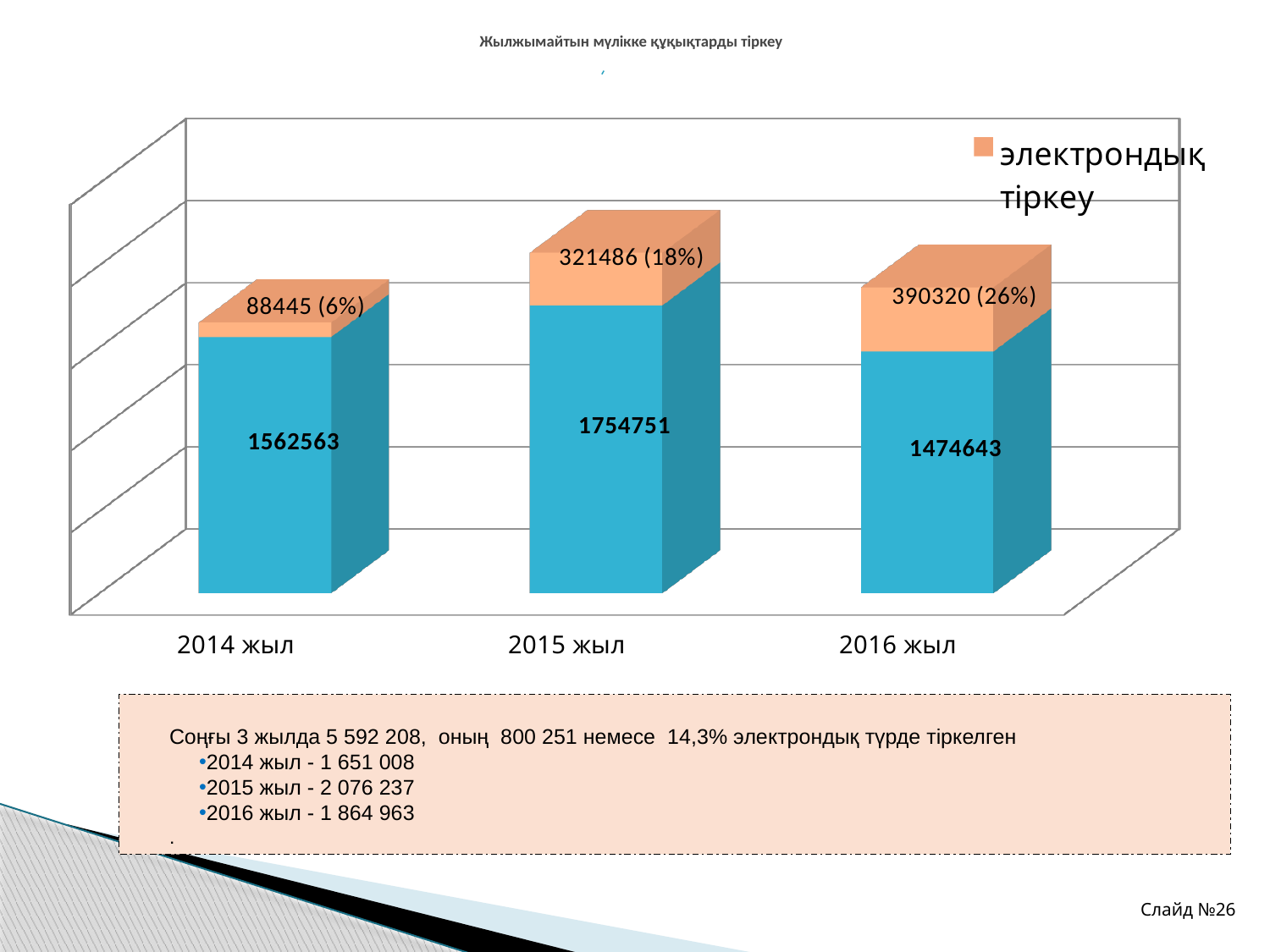
What is the value labelled on the электрондық тіркеу (orange) segment for 2015 жыл? 321486 (18%) How many series does the chart's legend list? 1 What is the total of the stacked bar for 2014 жыл (blue segment plus электрондық тіркеу)? 1651008 How many year categories are shown on the x axis of the chart? 3 Which year has the highest электрондық тіркеу (orange) value? 2016 жыл Which year has the lowest value in the blue segment? 2016 жыл What percentage is shown next to the электрондық тіркеу value for 2016 жыл? 26% What is the difference between the электрондық тіркеу values for 2016 жыл and 2014 жыл? 301875 What kind of chart is shown on the slide? bar chart Do the электрондық тіркеу values rise or fall from 2014 жыл to 2016 жыл? rise Which year has the larger blue segment value, 2014 жыл or 2015 жыл? 2015 жыл What is the value labelled on the blue segment of the bar for 2014 жыл? 1562563